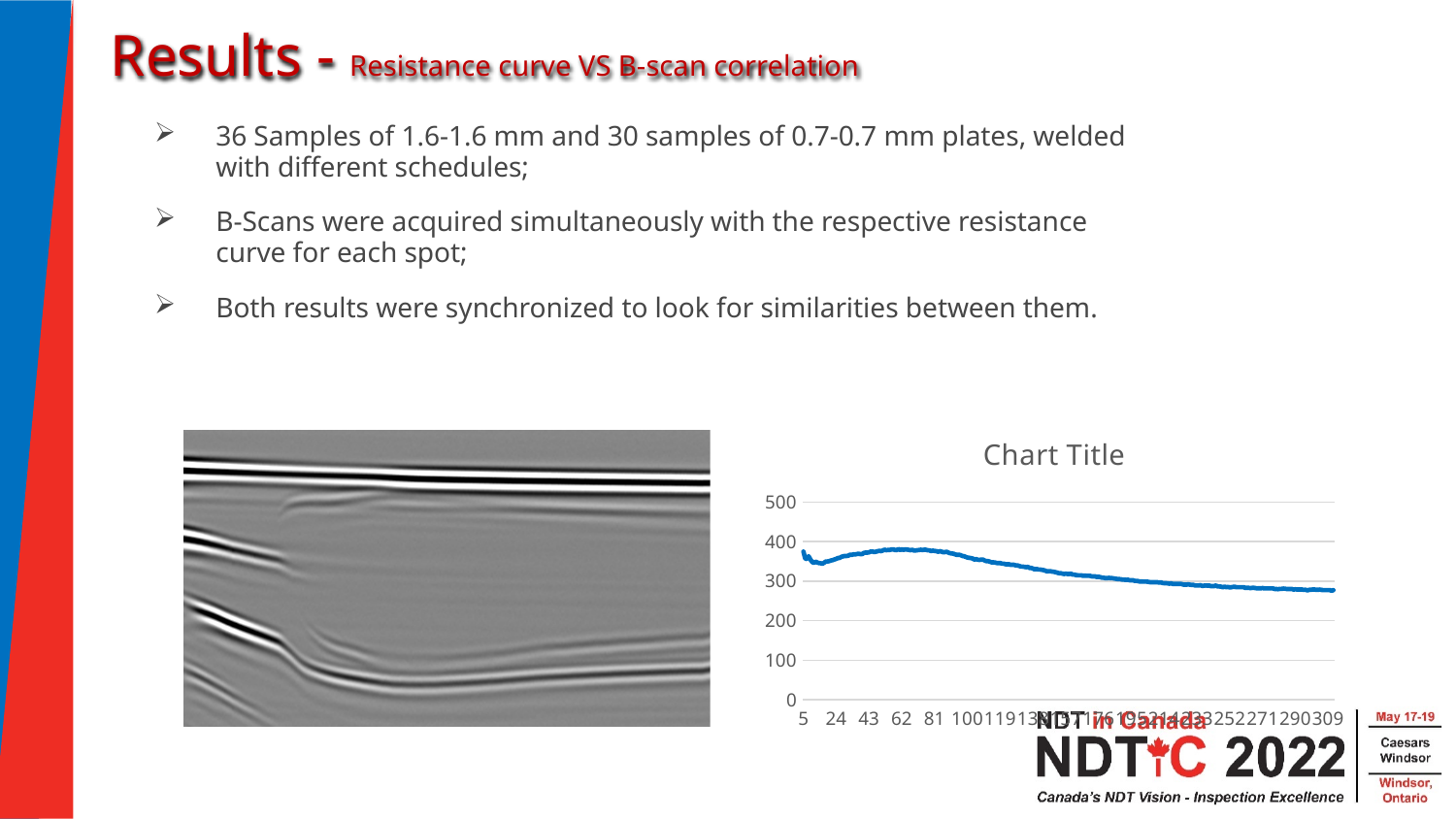
Is the value of the line at x = 5 greater or less than 300? greater What is the title of the chart on the slide? Chart Title Does the line ever rise above 400 on the chart? No Is the value of the line at x = 62 greater or less than 300? greater What is the highest value shown on the chart's vertical axis? 500 Which is larger, the value of the line at x = 5 or at x = 309? x = 5 What kind of chart is shown on the slide? line chart Overall, does the line rise or fall from the left of the x axis to the right? fall Which is larger, the value of the line at x = 62 or at x = 309? x = 62